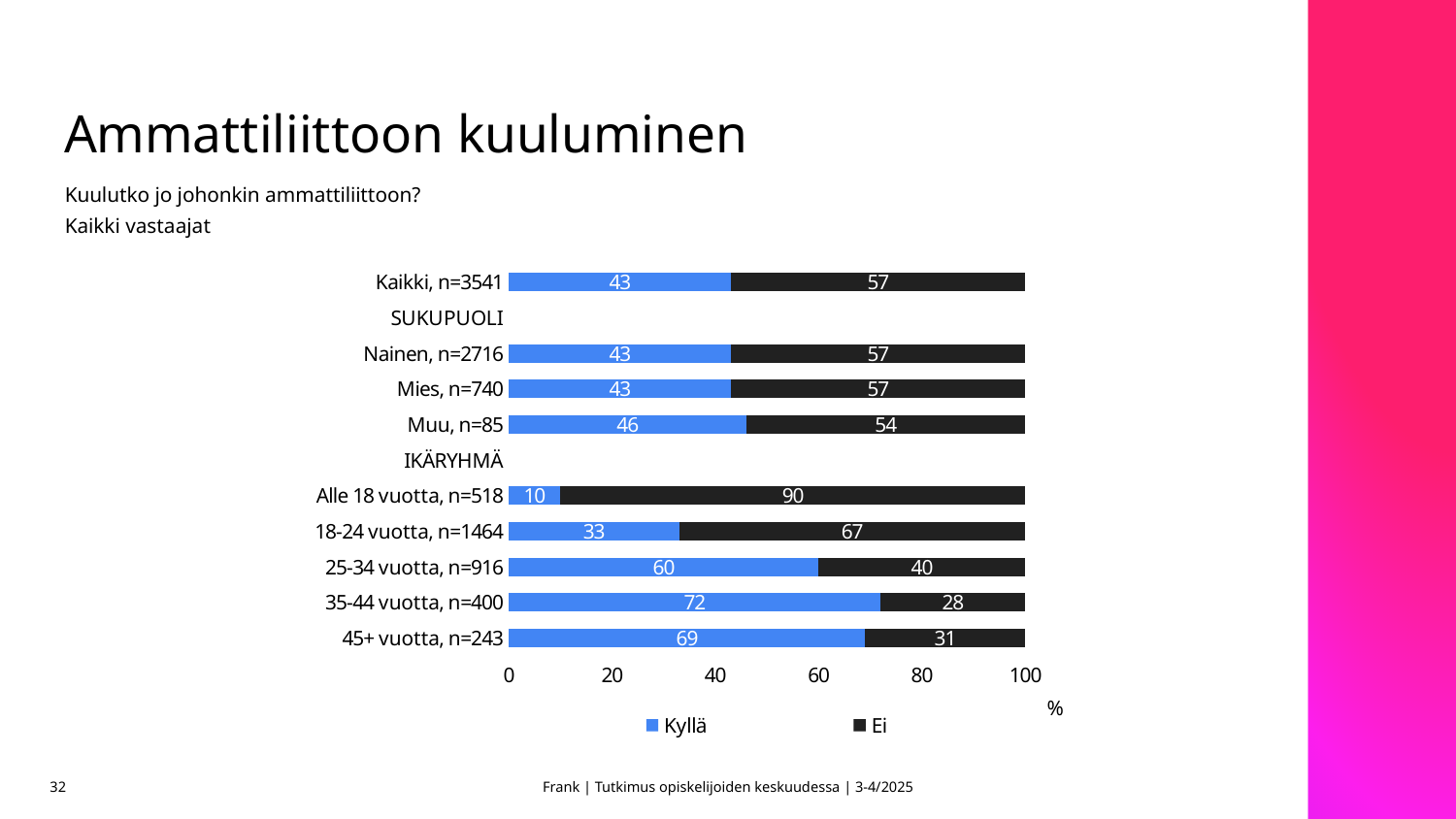
What is the Ei value for Alle 18 vuotta, n=518? 90 What is the Kyllä value for Kaikki, n=3541? 43 Which category has the highest Kyllä value? 35-44 vuotta, n=400 How many age groups (IKÄRYHMÄ) are shown in the chart? 5 Which category has the lowest Kyllä value? Alle 18 vuotta, n=518 What are the two legend entries of the chart? Kyllä and Ei What is the total of the stacked bar for Muu, n=85? 100 What kind of chart is shown on the slide? Stacked bar chart How many series does the legend list? 2 What is the difference between the Kyllä values for 25-34 vuotta, n=916 and 18-24 vuotta, n=1464? 27 Which is larger, the Kyllä value for 45+ vuotta, n=243 or for 35-44 vuotta, n=400? 35-44 vuotta, n=400 What is the Kyllä value for 35-44 vuotta, n=400? 72